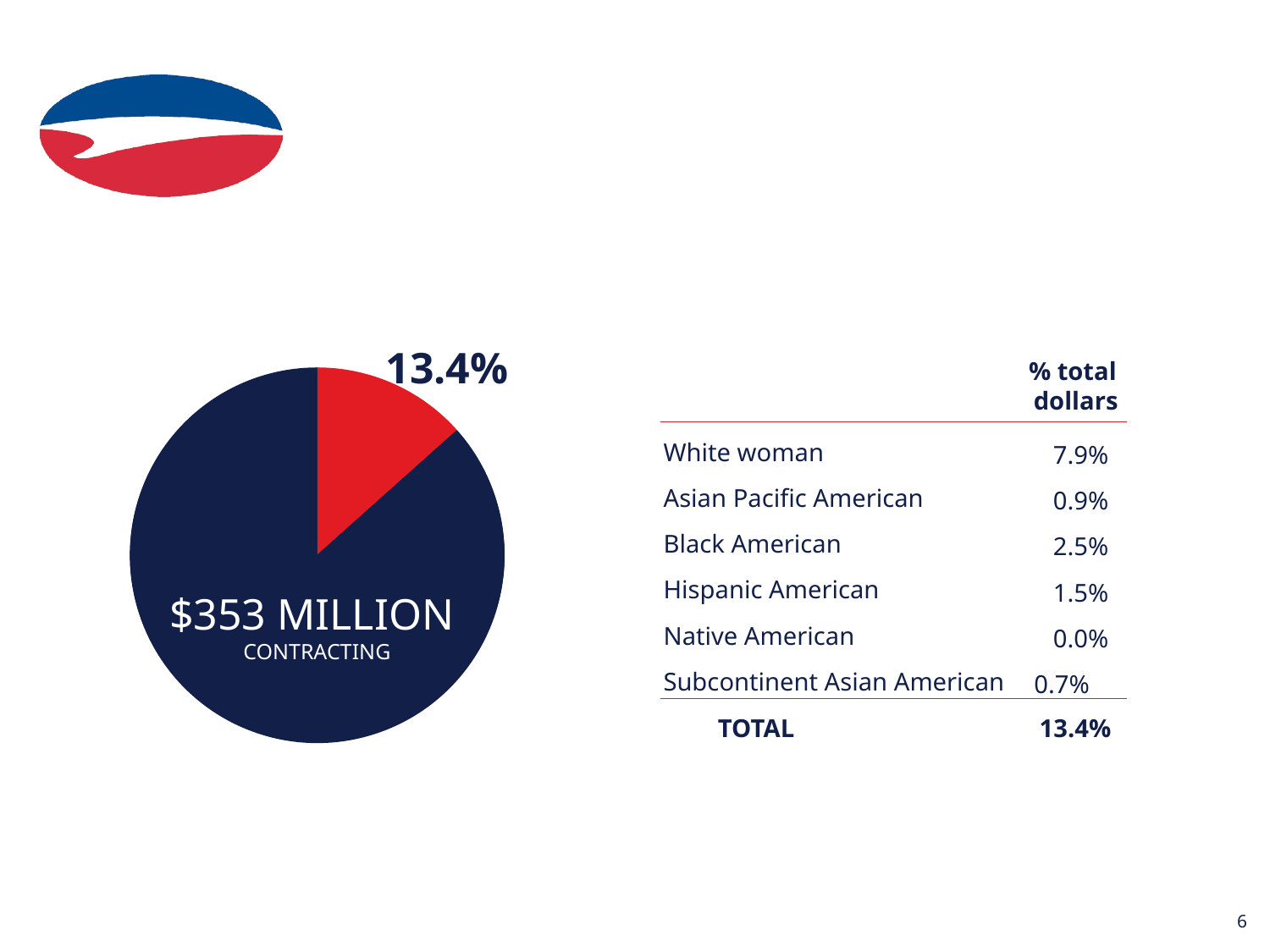
In the table next to the pie chart, what is the difference in % total dollars between White woman and Black American? 5.4% How many categories are listed in the table next to the pie chart, excluding the TOTAL row? 6 What percentage is labelled on the red slice of the pie chart? 13.4% In the table next to the pie chart, which category has the lowest % total dollars? Native American In the table next to the pie chart, what is the % total dollars for White woman? 7.9% What word appears below the dollar amount in the centre of the pie chart? CONTRACTING In the table next to the pie chart, which has a higher % total dollars, Black American or Hispanic American? Black American Which slice of the pie chart is larger, the red slice or the navy slice? the navy slice What dollar amount is printed in the centre of the pie chart? $353 MILLION In the table next to the pie chart, which category has the highest % total dollars? White woman What kind of chart is shown on the slide? pie chart How many slices does the pie chart have? 2